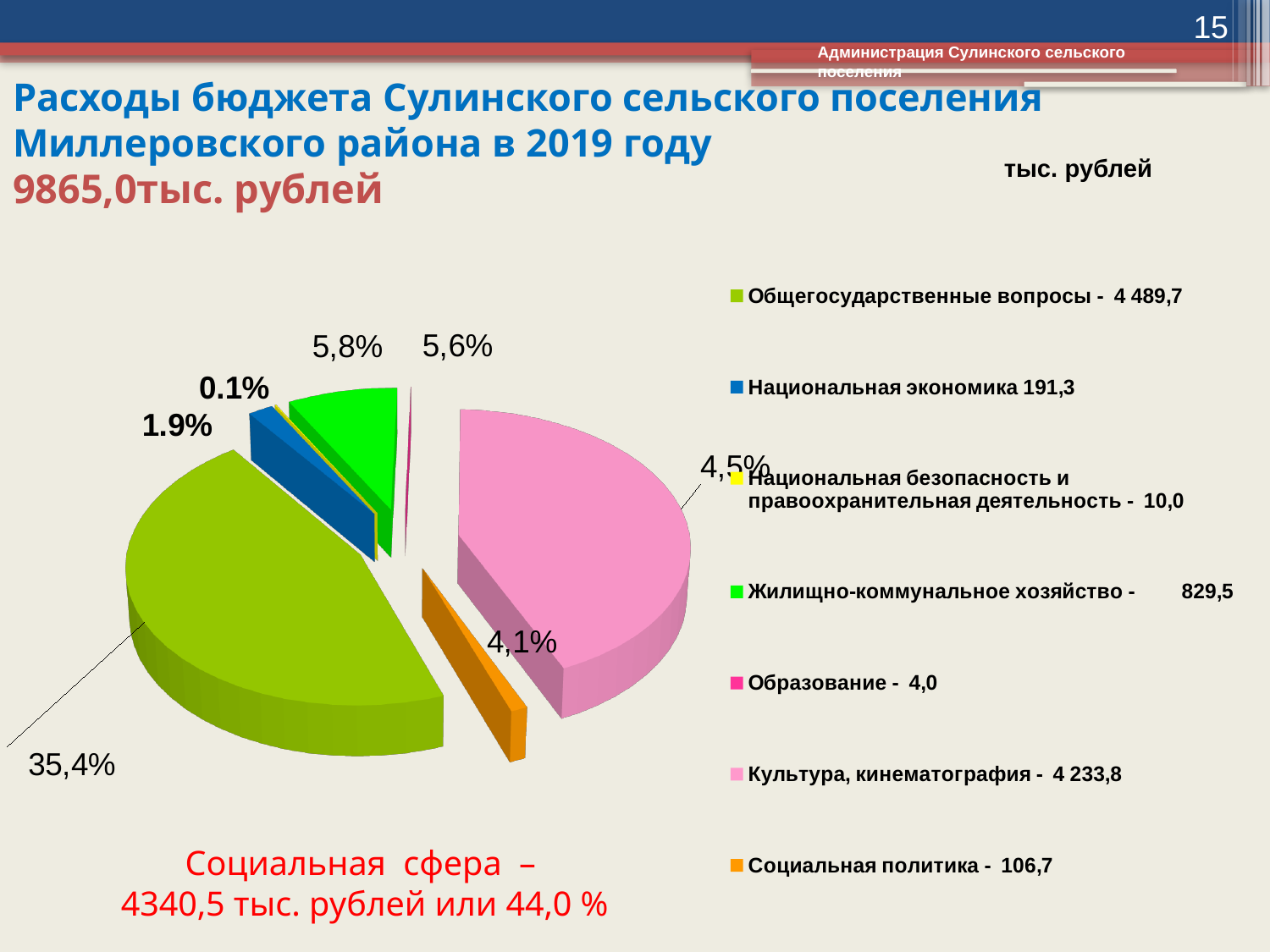
Which category has the highest value according to the legend? Общегосударственные вопросы What value is given in the legend for Общегосударственные вопросы? 4 489,7 How many categories does the legend of the pie chart list? 7 What value is given in the legend for Жилищно-коммунальное хозяйство? 829,5 What value is given in the legend for Социальная политика? 106,7 What is the difference between the values for Жилищно-коммунальное хозяйство and Национальная экономика? 638,2 What kind of chart is shown on the slide? pie chart What is the difference between the values for Общегосударственные вопросы and Культура, кинематография? 255,9 What unit is stated for the values on the slide? тыс. рублей Which category has the lowest value according to the legend? Образование What value is given in the legend for Культура, кинематография? 4 233,8 Which is larger: the value for Национальная экономика or the value for Социальная политика? Национальная экономика